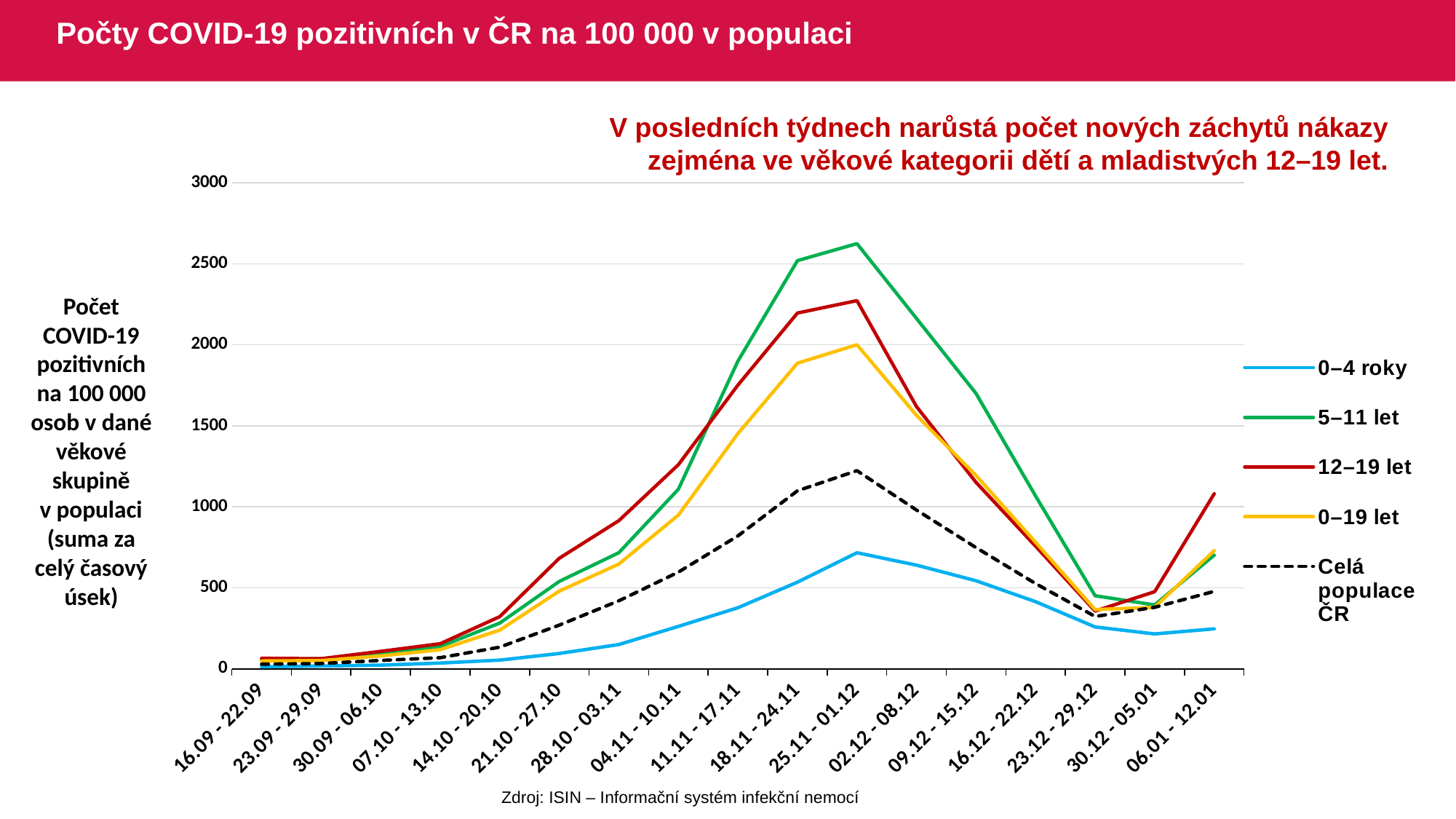
In the period 06.01 - 12.01, which is higher: 12–19 let or 5–11 let? 12–19 let Is the value for 0–4 roky in the period 25.11 - 01.12 greater or less than 1000? less Does the 5–11 let series rise or fall between 25.11 - 01.12 and 23.12 - 29.12? fall Which series stays lowest across the whole chart? 0–4 roky How many weekly periods are shown on the x axis? 17 What kind of chart is shown on the slide? line chart How many series does the legend list? 5 Which series reaches the highest value on the chart? 5–11 let Which series is drawn as a dashed line? Celá populace ČR Is the value for 12–19 let in the period 06.01 - 12.01 greater or less than 1000? greater Is the peak value for 5–11 let greater or less than 2500? greater In which period does the 5–11 let series reach its peak? 25.11 - 01.12